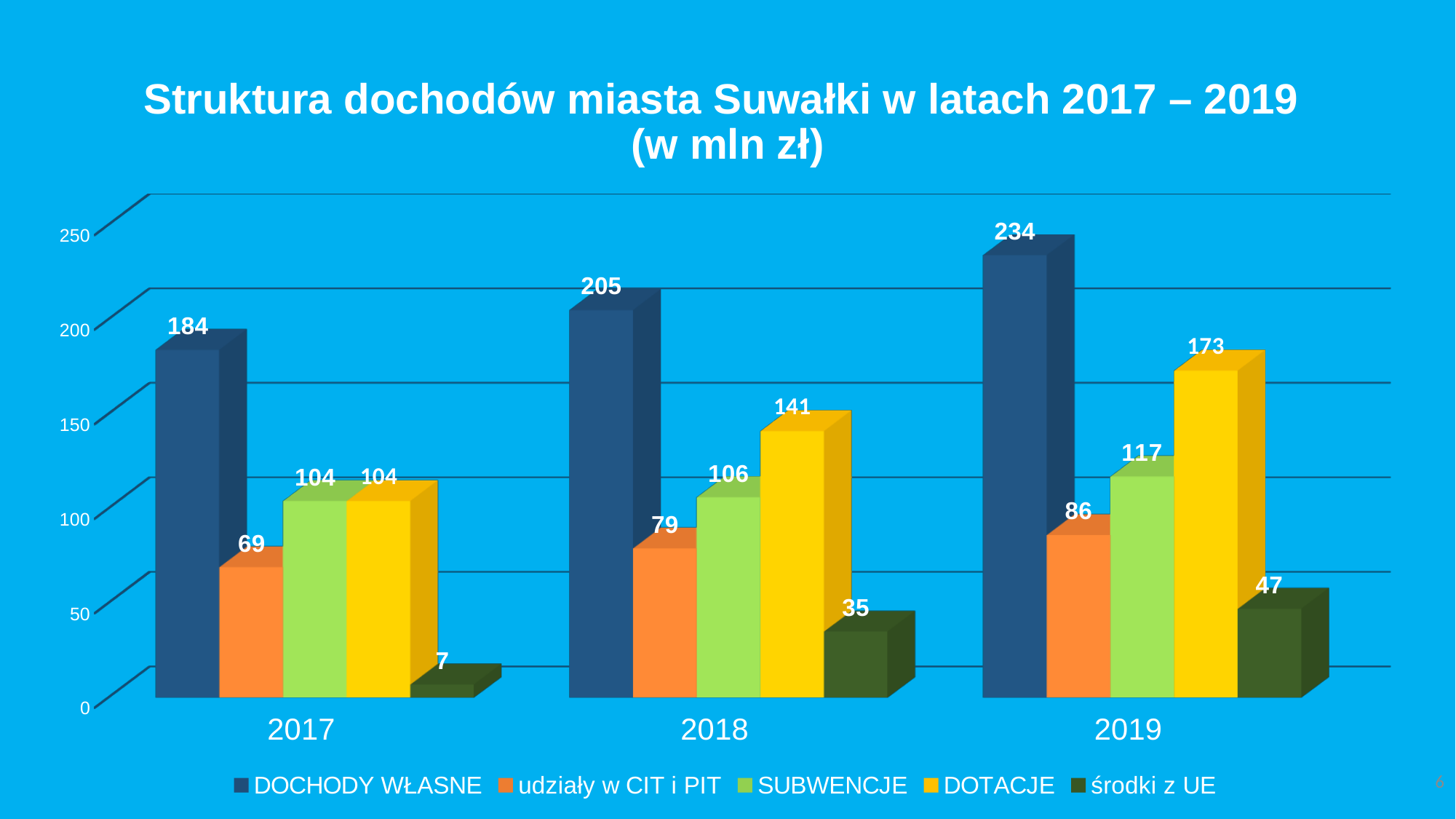
Which is larger in 2018: SUBWENCJE or udziały w CIT i PIT? SUBWENCJE What is the value for DOCHODY WŁASNE in 2019? 234 What is the value for DOTACJE in 2018? 141 Which series has the lowest value in 2018? środki z UE How many years are shown on the x axis? 3 What is the value for środki z UE in 2017? 7 What is the value for udziały w CIT i PIT in 2019? 86 Do the values for środki z UE rise or fall from 2017 to 2019? rise What is the difference between DOTACJE in 2019 and DOTACJE in 2017? 69 In which year is DOCHODY WŁASNE highest? 2019 What kind of chart is shown on the slide? bar chart How many series does the legend list? 5